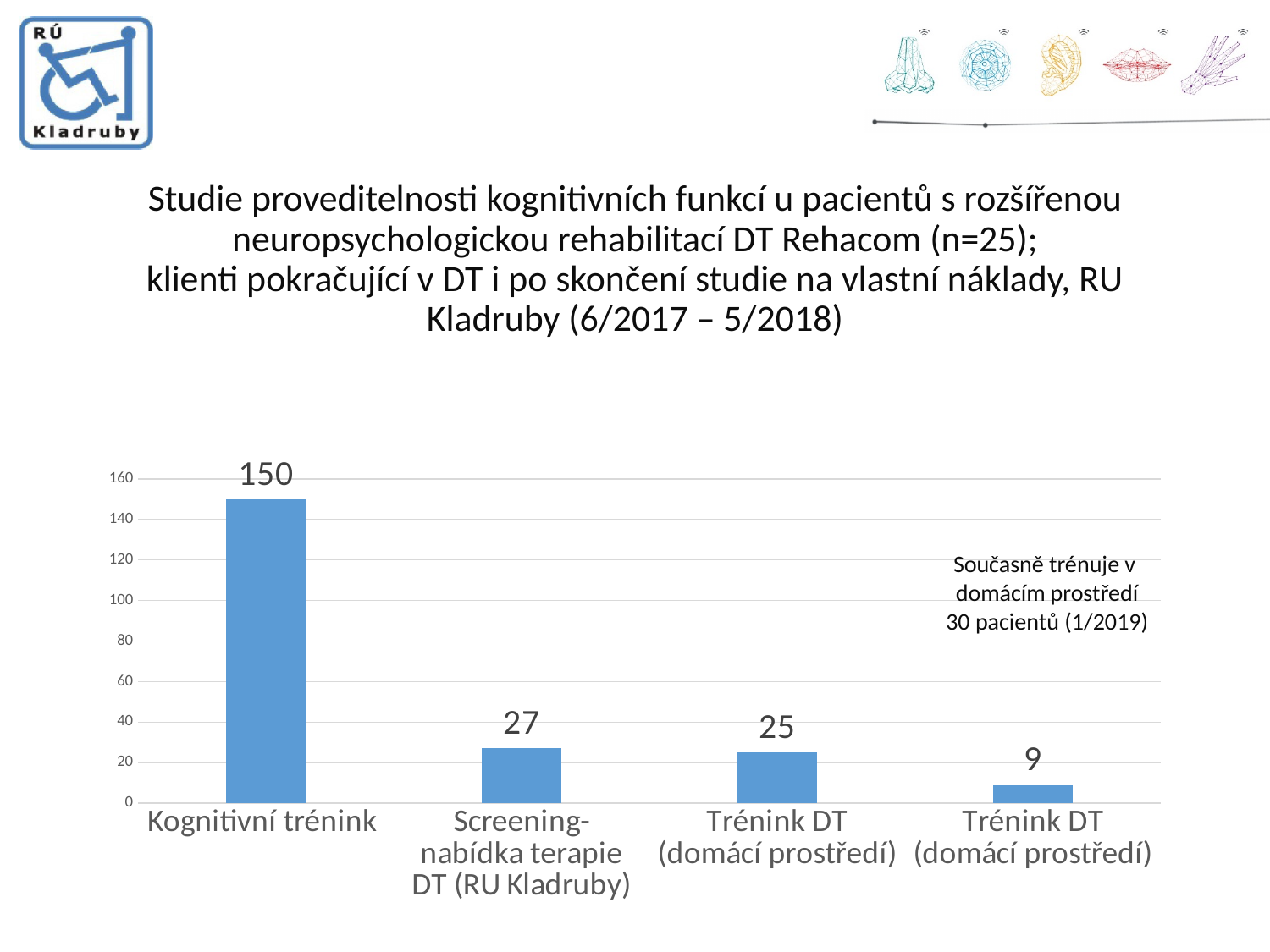
Which is larger: the value for Screening-nabídka terapie DT (RU Kladruby) or the value of the third bar from the left? Screening-nabídka terapie DT (RU Kladruby) How many bars are shown in the chart? 4 According to the text box on the chart, how many patients currently train in the home environment (1/2019)? 30 pacientů What is the value for Kognitivní trénink? 150 Which category has the highest value? Kognitivní trénink What is the difference between the value for Kognitivní trénink and the value for Screening-nabídka terapie DT (RU Kladruby)? 123 What is the difference between the third bar (25) and the rightmost bar (9)? 16 What is the value of the lowest bar in the chart? 9 What is the value of the rightmost bar, the second one labelled Trénink DT (domácí prostředí)? 9 What is the value for Screening-nabídka terapie DT (RU Kladruby)? 27 What is the value of the third bar from the left, the first one labelled Trénink DT (domácí prostředí)? 25 What kind of chart is shown on the slide? Bar chart